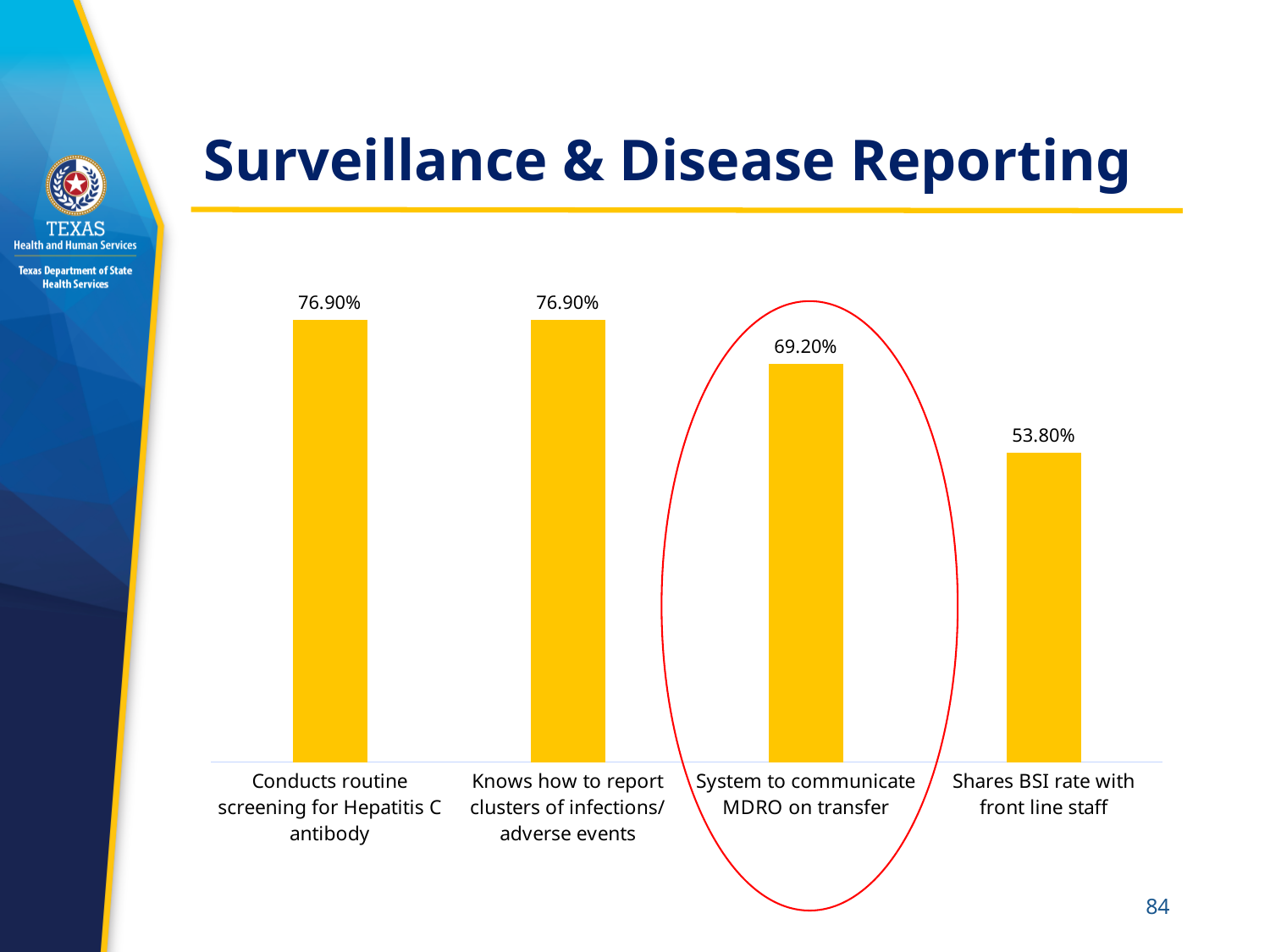
What is the difference between the values for "Knows how to report clusters of infections/adverse events" and "System to communicate MDRO on transfer"? 7.70% Which category is circled in red on the chart? System to communicate MDRO on transfer What is the value for "System to communicate MDRO on transfer"? 69.20% What kind of chart is shown on the slide? Bar chart How many categories are shown in the chart? 4 What is the difference between the values for "System to communicate MDRO on transfer" and "Shares BSI rate with front line staff"? 15.40% Which is larger: the value for "System to communicate MDRO on transfer" or the value for "Shares BSI rate with front line staff"? System to communicate MDRO on transfer What is the value for "Conducts routine screening for Hepatitis C antibody"? 76.90% What is the value for "Shares BSI rate with front line staff"? 53.80% What is the title of the slide containing the chart? Surveillance & Disease Reporting Do the values rise or fall from left to right across the chart? Fall Which category has the lowest value? Shares BSI rate with front line staff